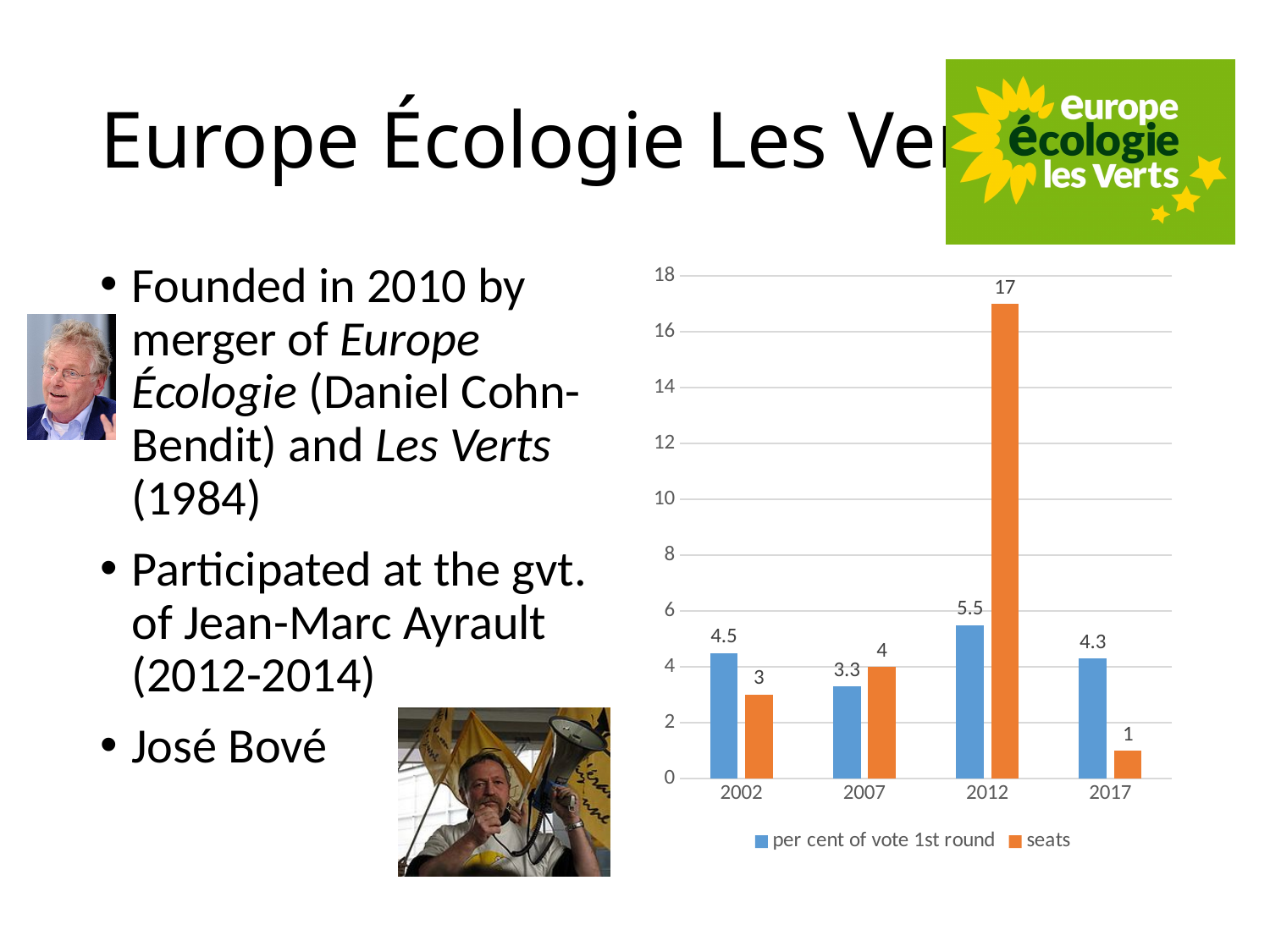
Which is larger: the per cent of vote 1st round in 2002 or in 2017? 2002 What is the per cent of vote 1st round value for 2007? 3.3 How many seats are shown for 2017? 1 Which year has the lowest per cent of vote 1st round? 2007 How many years are shown on the x axis? 4 Which year has the highest number of seats? 2012 What kind of chart is shown on the slide? bar chart What is the difference in seats between 2012 and 2017? 16 How many series does the legend list? 2 Is the seats value for 2012 greater or less than 16? greater Which colour represents the seats series? orange What is the per cent of vote 1st round value for 2012? 5.5